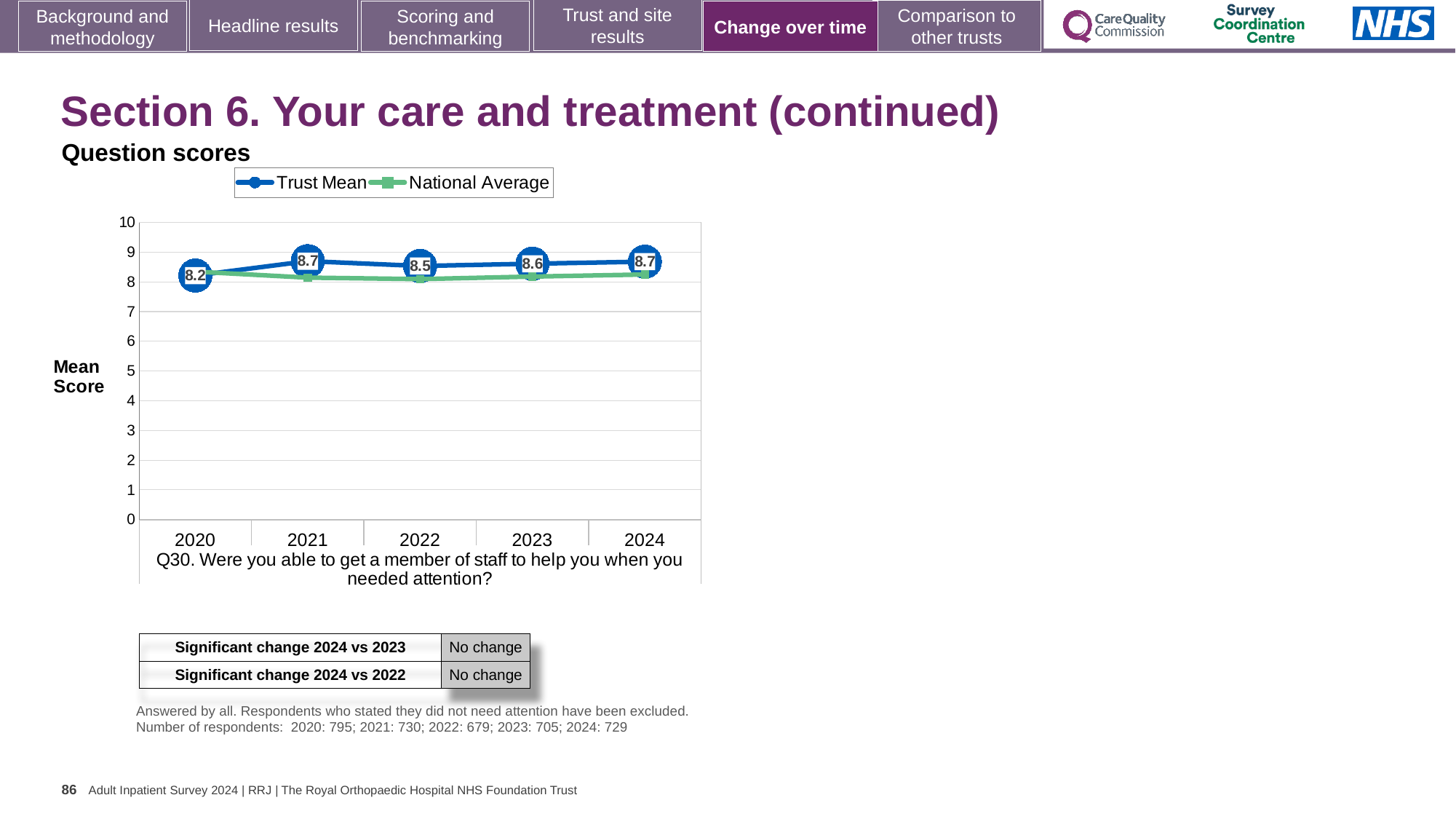
Is the Trust Mean score for 2023 larger than the Trust Mean score for 2020? Yes What is the Trust Mean score for 2022? 8.5 Does the Trust Mean rise or fall from 2022 to 2024? Rise What is the difference between the Trust Mean scores for 2021 and 2020? 0.5 What kind of chart is shown? Line chart What is the Trust Mean score for 2020? 8.2 How many series does the legend list? 2 Is the National Average value for 2022 greater or less than 9? less How many years are shown on the x axis? 5 In which year is the Trust Mean score lowest? 2020 Which series is shown in green in the legend? National Average What is the Trust Mean score for 2024? 8.7